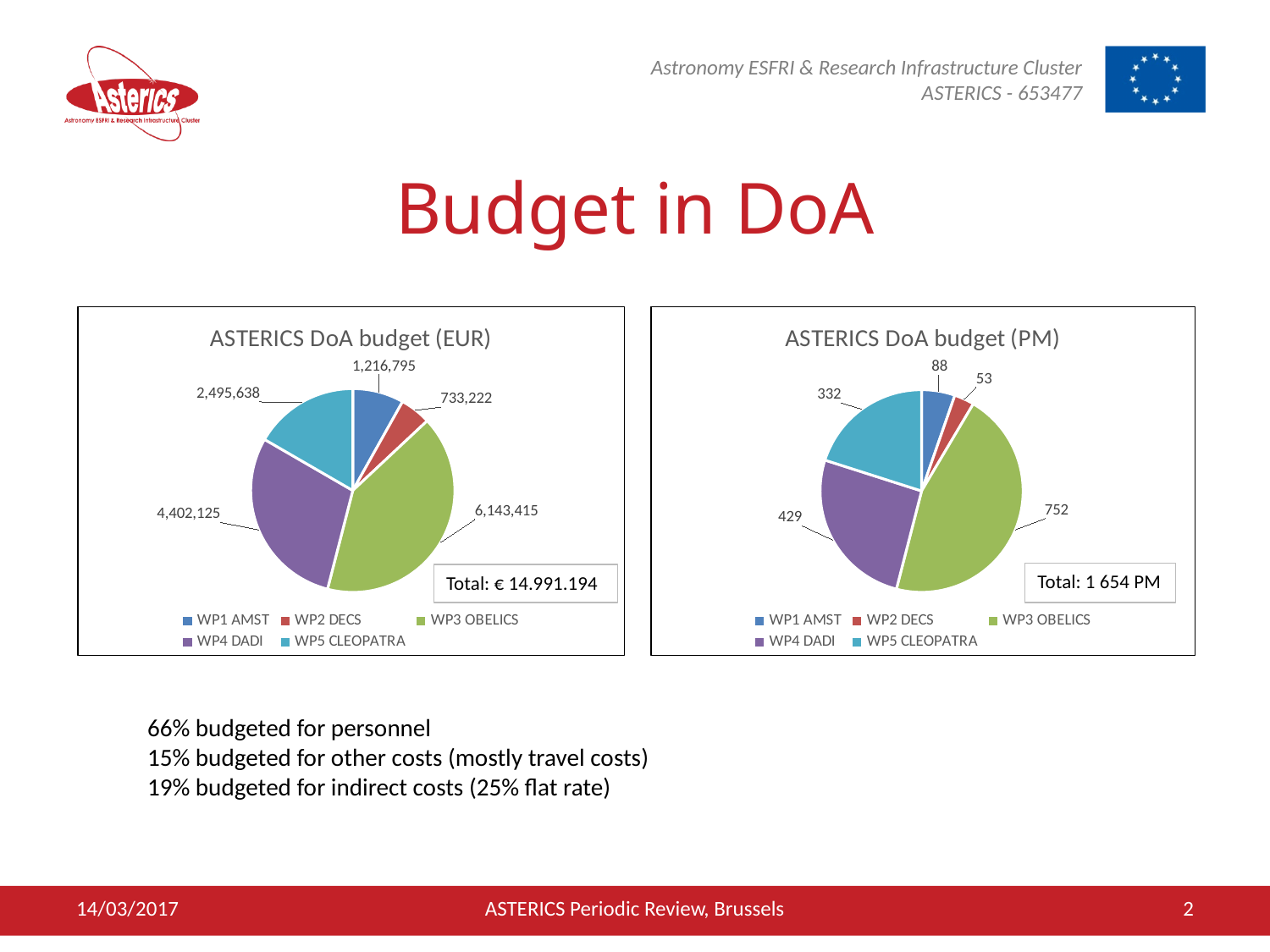
In the ASTERICS DoA budget (PM) chart, what is the difference between WP4 DADI and WP5 CLEOPATRA? 97 In the ASTERICS DoA budget (EUR) chart, what is the difference between WP3 OBELICS and WP4 DADI? 1,741,290 In the ASTERICS DoA budget (PM) chart, which work package has the smallest value? WP2 DECS In the ASTERICS DoA budget (PM) chart, what is the value for WP2 DECS? 53 In the ASTERICS DoA budget (EUR) chart, which work package has the largest budget? WP3 OBELICS In the ASTERICS DoA budget (EUR) chart, what is the value for WP5 CLEOPATRA? 2,495,638 In the ASTERICS DoA budget (EUR) chart, what is the value for WP3 OBELICS? 6,143,415 In the ASTERICS DoA budget (PM) chart, which is larger, WP1 AMST or WP5 CLEOPATRA? WP5 CLEOPATRA In the ASTERICS DoA budget (PM) chart, what is the value for WP4 DADI? 429 How many work packages are shown in the ASTERICS DoA budget (EUR) pie chart? 5 What type of chart is the ASTERICS DoA budget (PM) chart? Pie chart What total is shown in the box on the ASTERICS DoA budget (PM) chart? Total: 1 654 PM